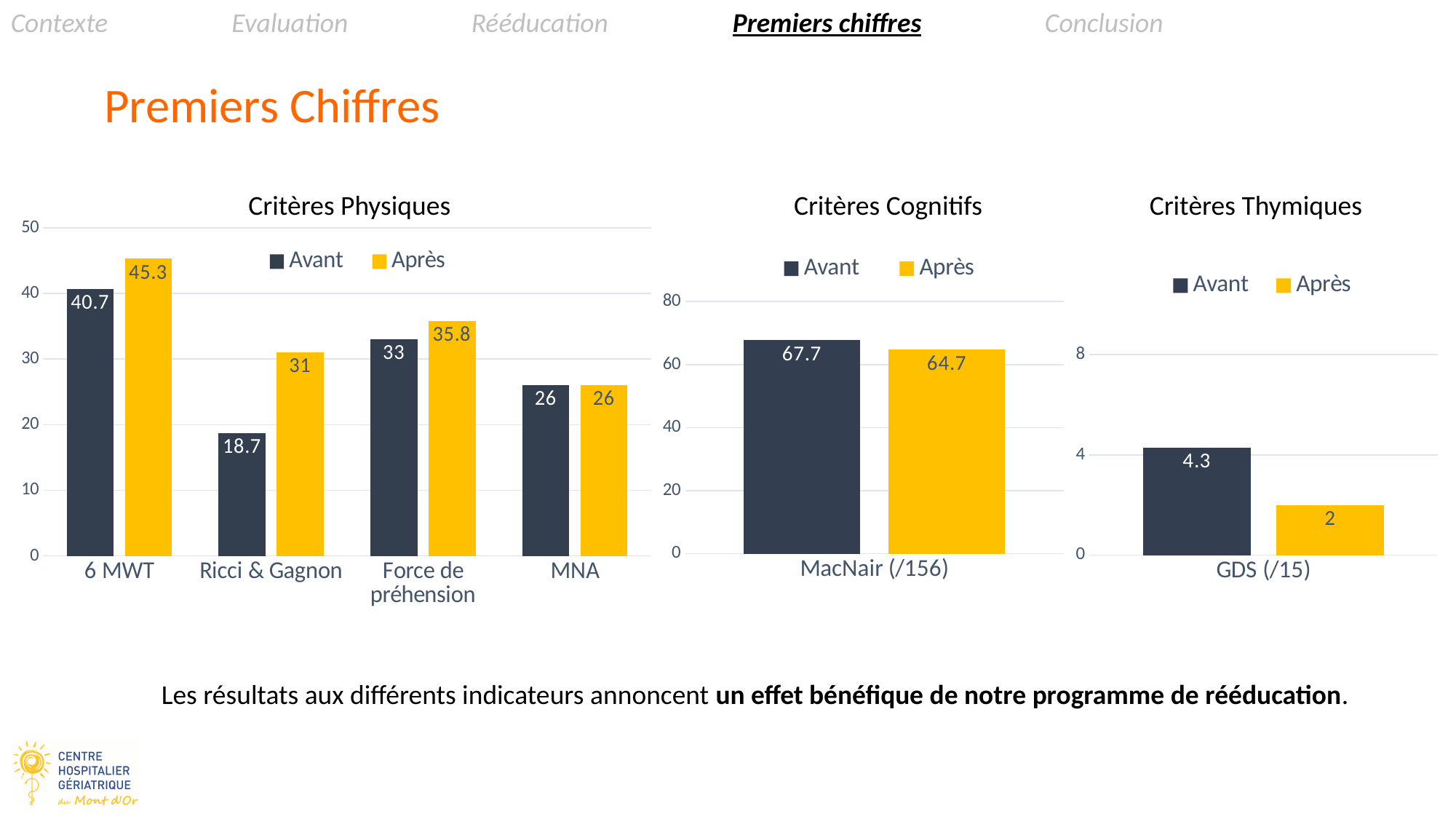
In the 'Critères Thymiques' chart, what is the difference between the Avant and Après values for GDS (/15)? 2.3 What kind of chart is the 'Critères Cognitifs' chart? Bar chart In the 'Critères Cognitifs' chart, which is larger for MacNair (/156): the Avant value or the Après value? Avant How many series does the legend of the 'Critères Thymiques' chart list? 2 In the 'Critères Physiques' chart, what is the Avant value for 6 MWT? 40.7 In the 'Critères Physiques' chart, what is the difference between the Après and Avant values for Force de préhension? 2.8 In the 'Critères Thymiques' chart, what is the Après value for GDS (/15)? 2 In the 'Critères Physiques' chart, what is the Après value for Ricci & Gagnon? 31 In the 'Critères Physiques' chart, which category has the lowest Avant value? Ricci & Gagnon In the 'Critères Physiques' chart, which category has the highest Après value? 6 MWT In the 'Critères Physiques' chart, how many categories are shown on the x axis? 4 In the 'Critères Cognitifs' chart, what is the Avant value for MacNair (/156)? 67.7